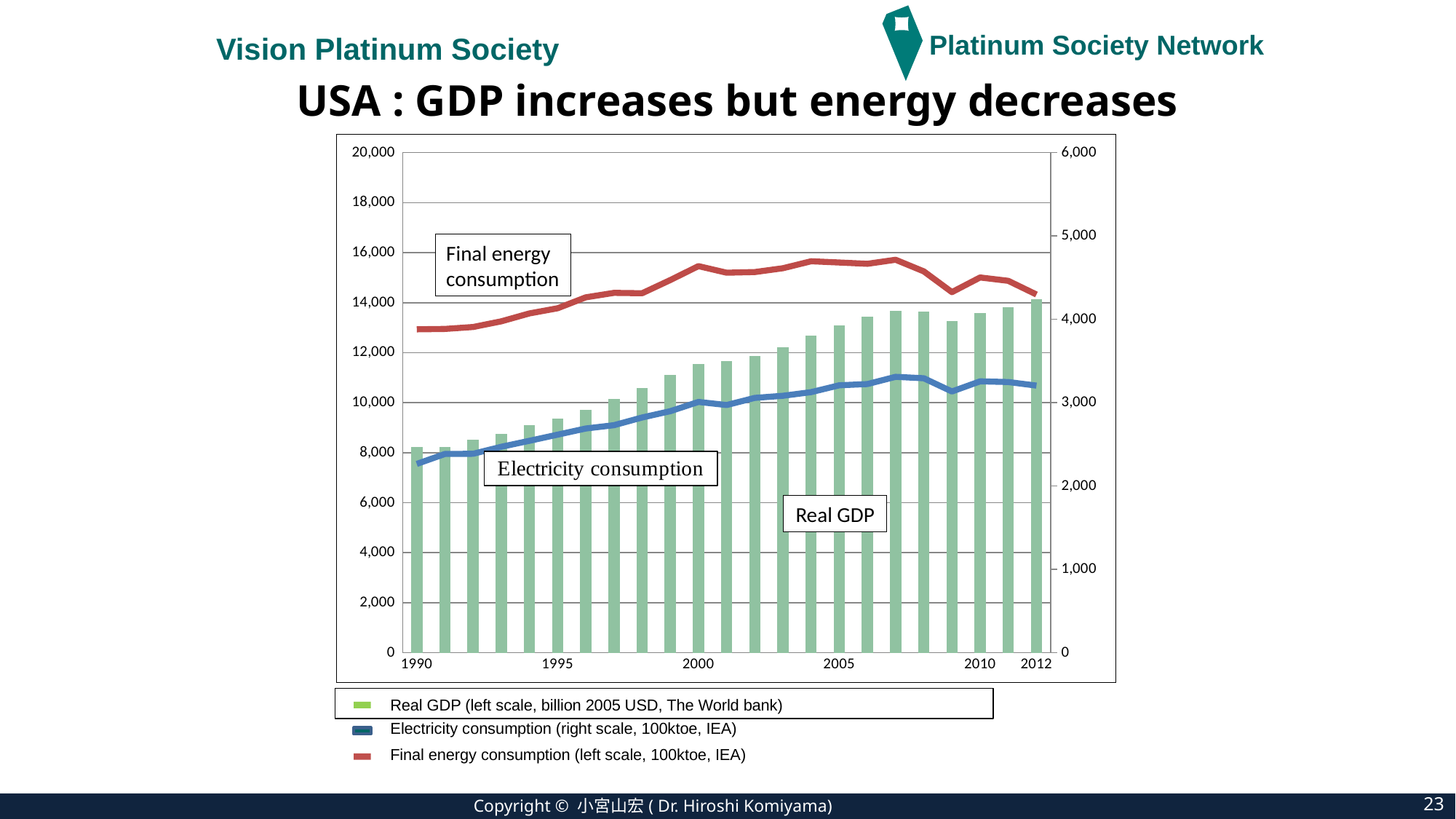
Is the Real GDP value for 1990 greater or less than 10,000 on the left scale? less How many series does the legend list? 3 Does Real GDP generally rise or fall from 1990 to 2012? Rise According to the legend, which scale does the Electricity consumption series use? Right scale In which year is Real GDP highest? 2012 Is the Final energy consumption value for 1990 greater or less than 14,000 on the left scale? less Is the Real GDP value for 2005 greater or less than 12,000 on the left scale? greater What kind of chart is shown on the slide? A combined bar and line chart Which is larger, Final energy consumption in 2007 or in 2012? 2007 Which is larger, Real GDP in 2008 or in 2009? 2008 How many Real GDP bars are plotted in the chart? 23